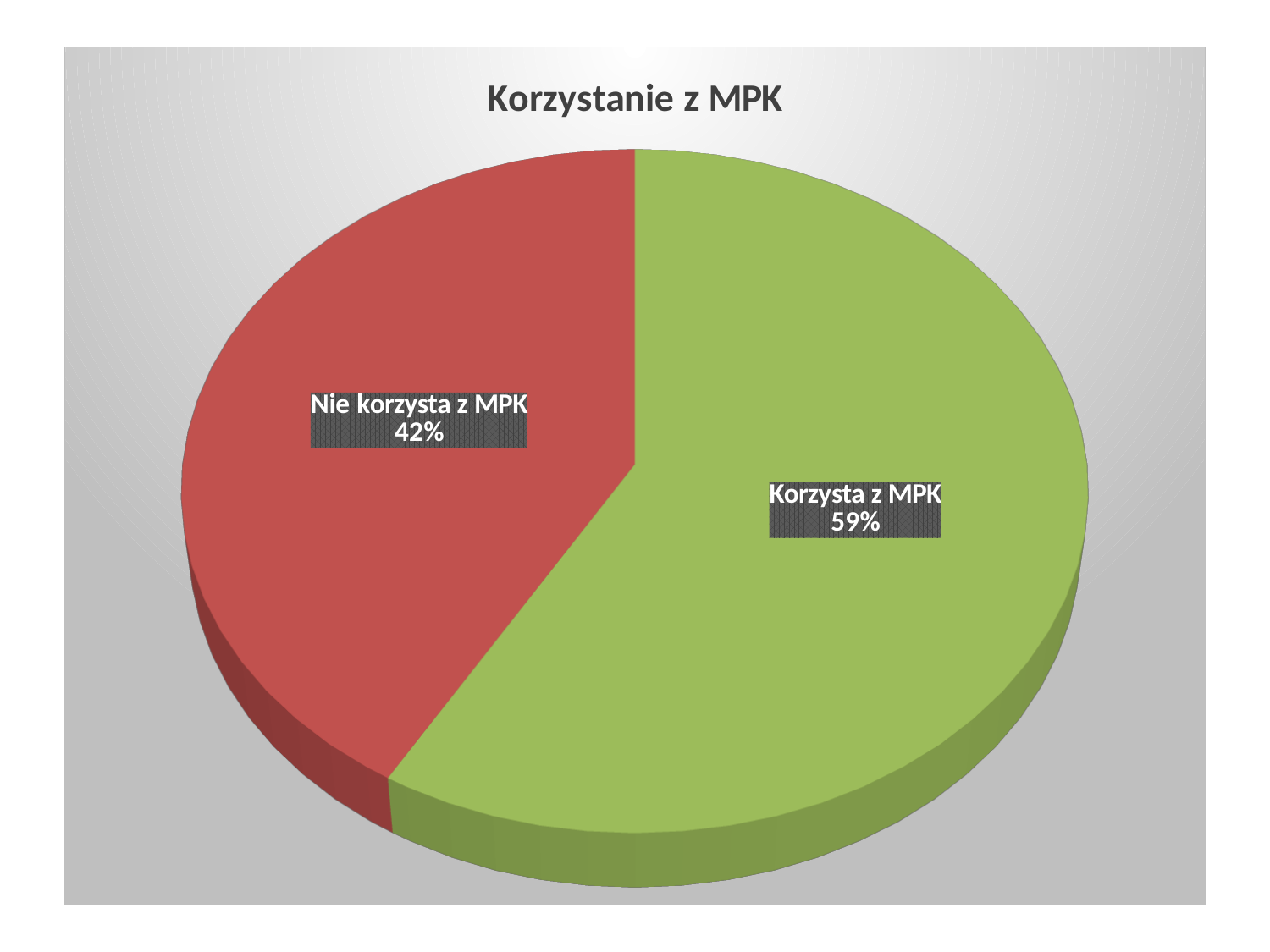
How many slices does the pie chart have? 2 What kind of chart is shown on the slide? pie chart What colour is the "Korzysta z MPK" slice? green By how many percentage points does the "Korzysta z MPK" share exceed the "Nie korzysta z MPK" share? 17 What share of the pie is labelled "Korzysta z MPK"? 59% What is the title of the chart? Korzystanie z MPK Which slice is the largest? Korzysta z MPK Which slice is the smallest? Nie korzysta z MPK Which is larger, the "Korzysta z MPK" slice or the "Nie korzysta z MPK" slice? Korzysta z MPK What share of the pie is labelled "Nie korzysta z MPK"? 42%